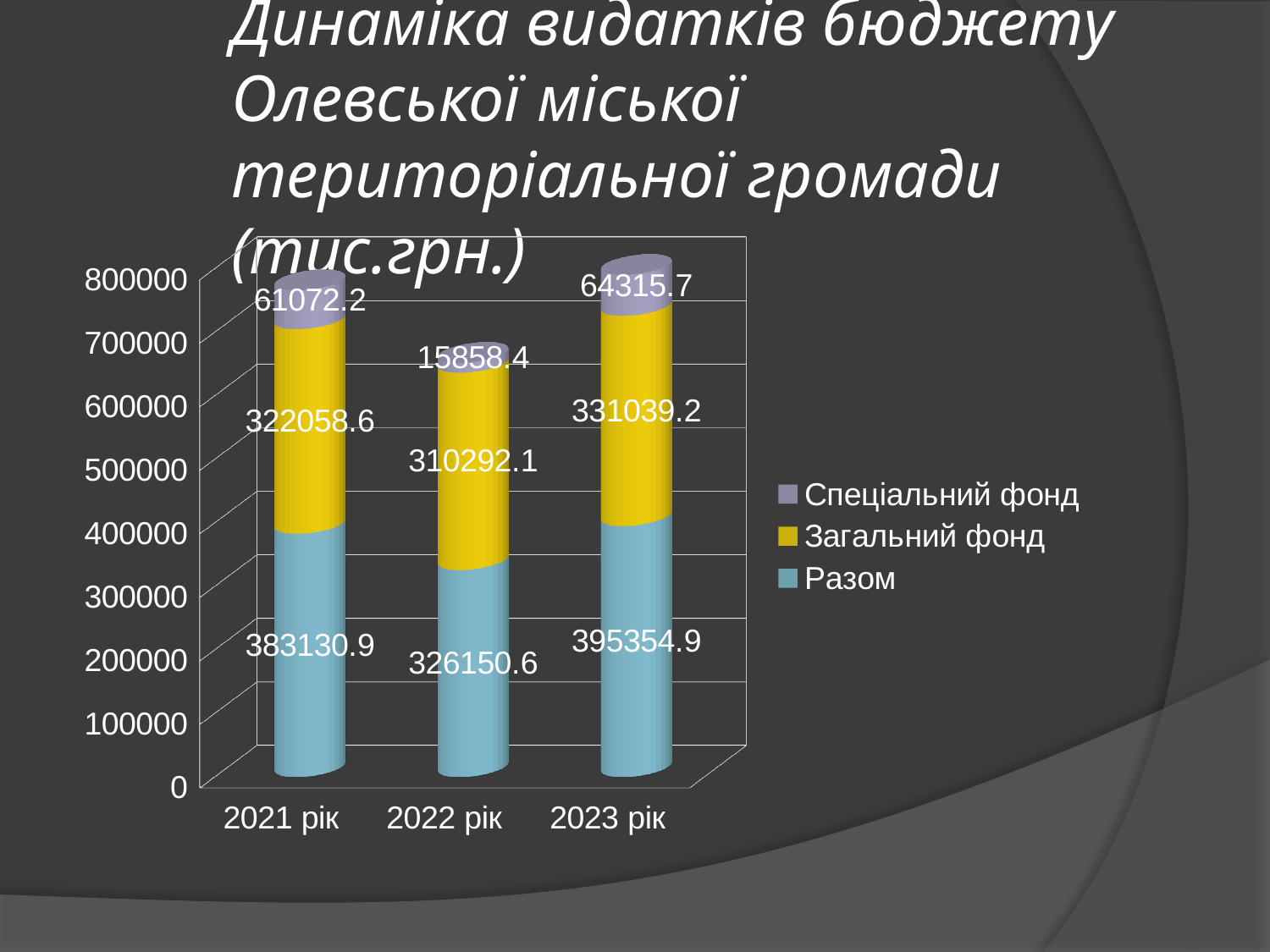
What is the value of Загальний фонд for 2023 рік? 331039.2 What is the value of Разом for 2021 рік? 383130.9 Which year has the lowest value for Разом? 2022 рік What kind of chart is shown on the slide? Stacked bar chart What is the difference between the Разом values for 2023 рік and 2022 рік? 69204.3 How many years are shown on the x axis? 3 How many series does the legend list? 3 Which series is shown in yellow? Загальний фонд What is the value of Спеціальний фонд for 2022 рік? 15858.4 Which is larger: Загальний фонд for 2021 рік or Загальний фонд for 2022 рік? 2021 рік Which year has the highest value for Спеціальний фонд? 2023 рік What is the total of the stacked bar for 2022 рік? 652301.1